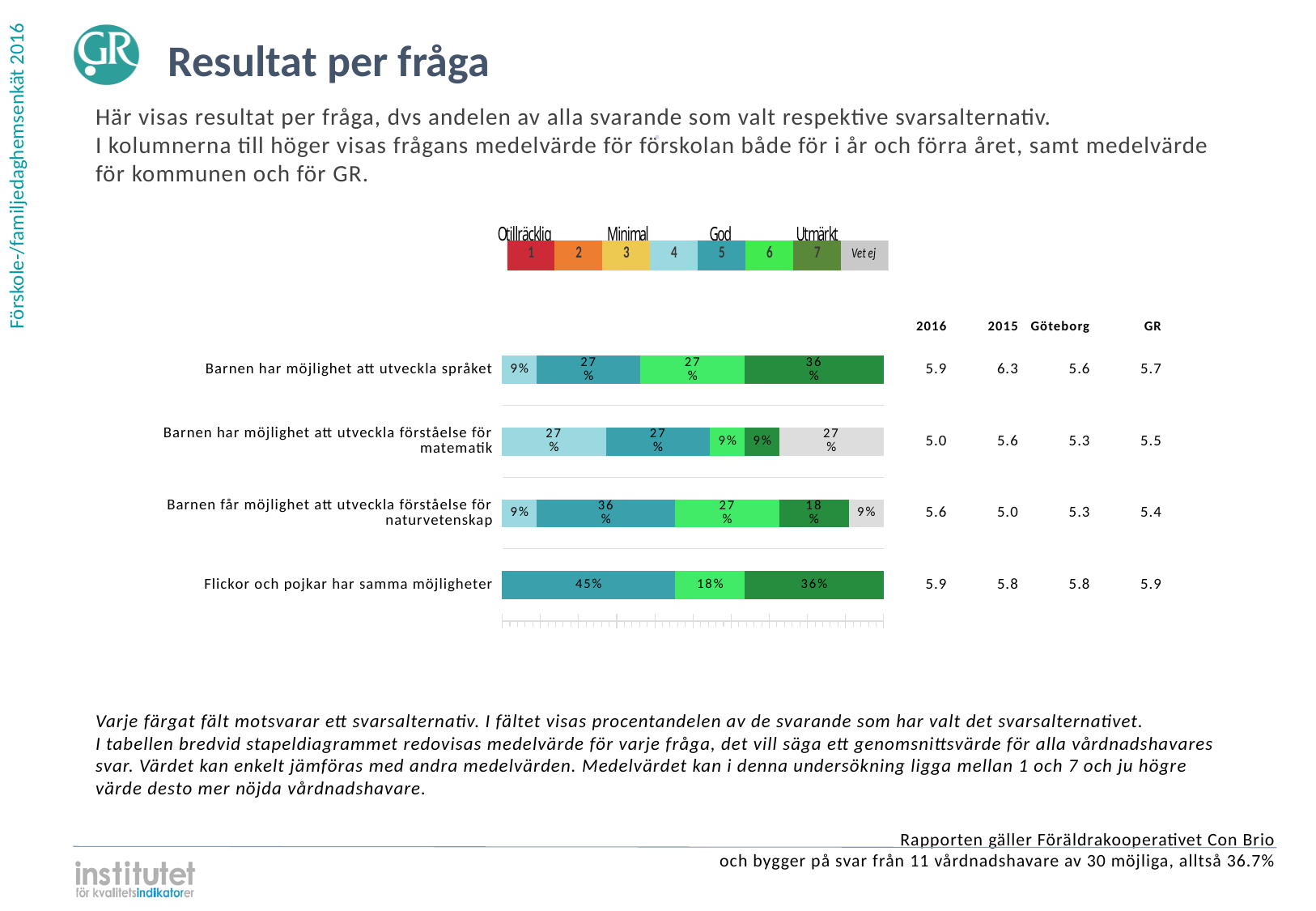
How many questions (categories) are plotted in the bar chart? 4 What percentage chose 7 (Utmärkt) for 'Barnen får möjlighet att utveckla förståelse för naturvetenskap'? 18% What kind of chart is shown on the slide? Stacked bar chart What percentage of respondents chose 7 (Utmärkt) for 'Barnen har möjlighet att utveckla språket'? 36% What is the 2016 mean value shown for 'Barnen har möjlighet att utveckla förståelse för matematik'? 5.0 Which is larger for 'Barnen får möjlighet att utveckla förståelse för naturvetenskap': the share answering 5 (God) or the share answering 6? 5 (God) What percentage chose 5 (God) for 'Flickor och pojkar har samma möjligheter'? 45% What percentage chose 'Vet ej' for 'Barnen har möjlighet att utveckla förståelse för matematik'? 27% Which question has the largest 'Vet ej' share? Barnen har möjlighet att utveckla förståelse för matematik How many answer alternatives does the legend above the chart list? 8 Which question has the largest share of respondents answering 5 (God)? Flickor och pojkar har samma möjligheter What is the difference between the share answering 5 (God) and the share answering 6 for 'Flickor och pojkar har samma möjligheter'? 27%